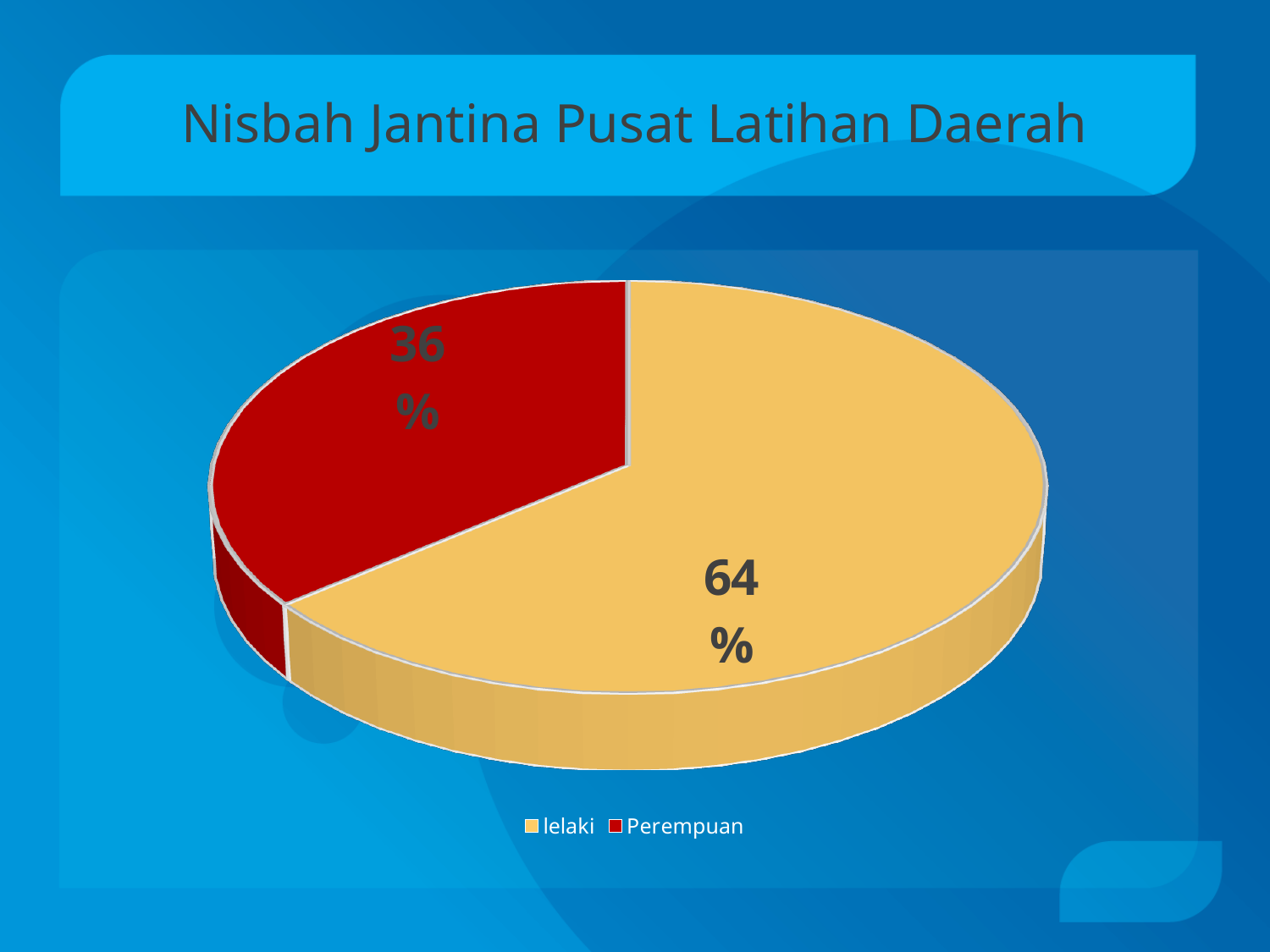
What percentage of the pie is labelled for lelaki? 64% How many entries does the legend list? 2 What type of chart is shown on the slide? pie chart What colour is the Perempuan slice? red What percentage of the pie is labelled for Perempuan? 36% What is the difference in percentage points between the lelaki and Perempuan slices? 28 Which category has the smallest share of the pie? Perempuan How many slices does the pie chart have? 2 What is the title of the chart? Nisbah Jantina Pusat Latihan Daerah Which slice is larger, lelaki or Perempuan? lelaki Which category has the largest share of the pie? lelaki What share of the pie does the lelaki slice represent? 64%